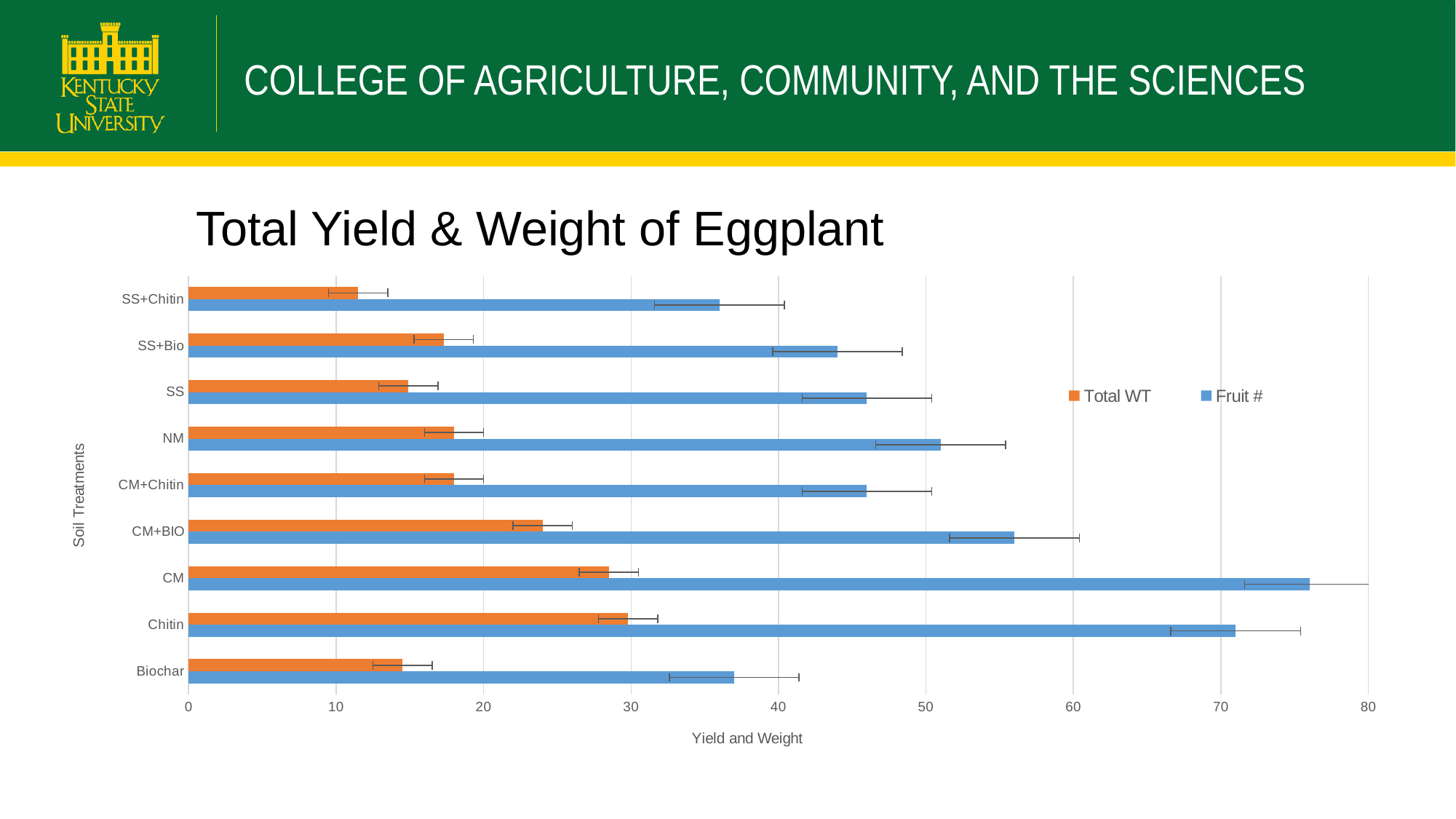
Which soil treatment has the lowest Total WT value? SS+Chitin Is the Total WT value for CM+BIO greater or less than 20? greater Which soil treatment has the highest Fruit # value? CM How many soil treatments are listed on the vertical axis of the chart? 9 Is the Total WT value for Biochar greater or less than 20? less Which has the larger Total WT value, SS+Bio or SS+Chitin? SS+Bio Which has the larger Fruit # value, CM+BIO or NM? CM+BIO What is the title of the chart? Total Yield & Weight of Eggplant Is the Fruit # value for SS+Chitin greater or less than 40? less How many series does the chart legend list? 2 What kind of chart is shown on the slide? bar chart